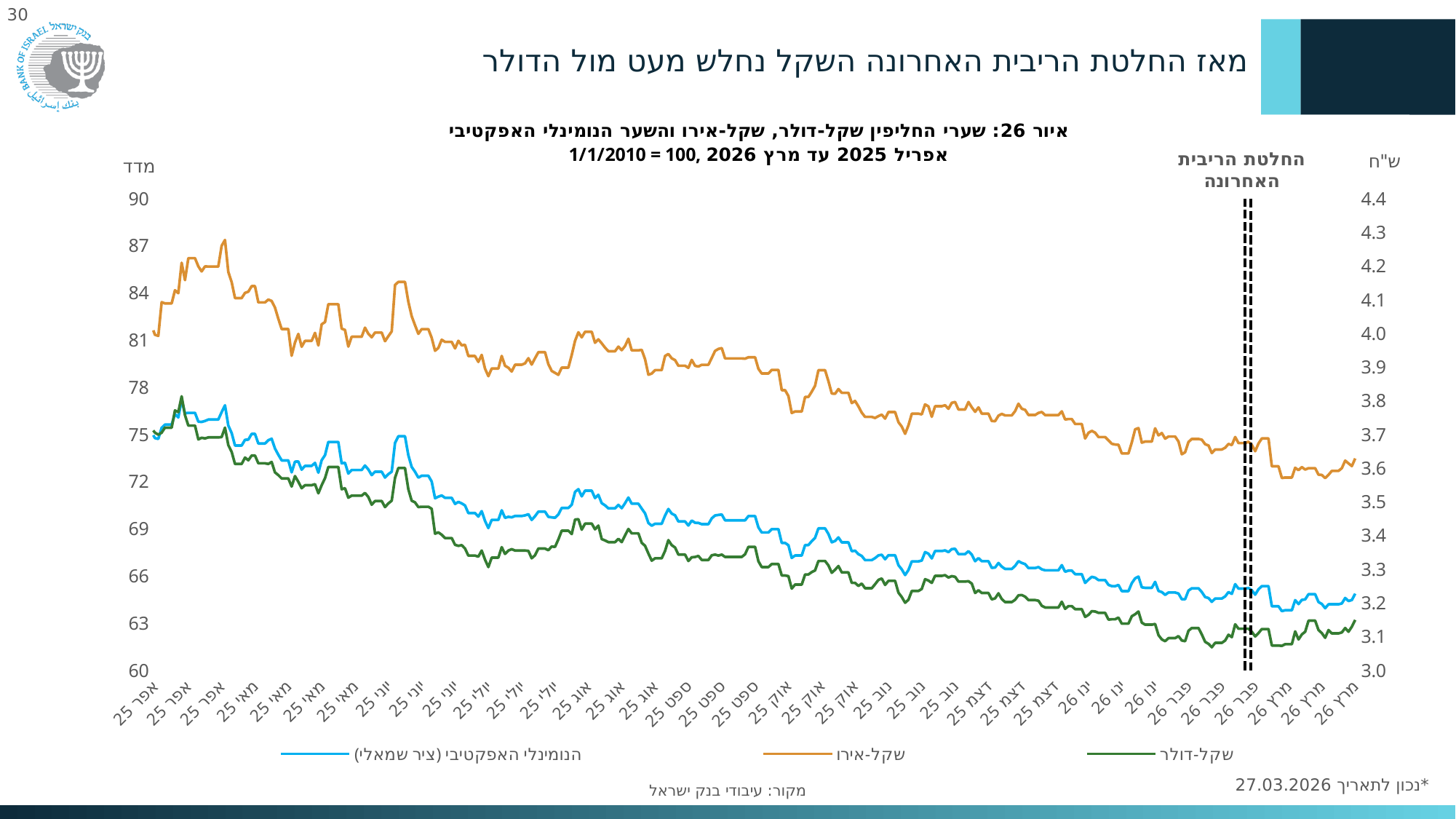
Does the שקל-דולר series rise or fall overall from April 2025 to March 2026? fall Which series has the higher value in March 2026 on the right axis, שקל-אירו or שקל-דולר? שקל-אירו Does the שקל-אירו series rise or fall overall from April 2025 to March 2026? fall How many series does the legend list? 3 Which series is plotted on the left axis according to the legend? הנומינלי האפקטיבי (ציר שמאלי) Is the value of the שקל-אירו series in April 2025 greater or less than 3.9? greater Is the value of the הנומינלי האפקטיבי series in March 2026 greater or less than 70? less Is the value of the הנומינלי האפקטיבי series in April 2025 greater or less than 70? greater What kind of chart is shown on the slide? line chart What is the figure number given in the chart title? איור 26